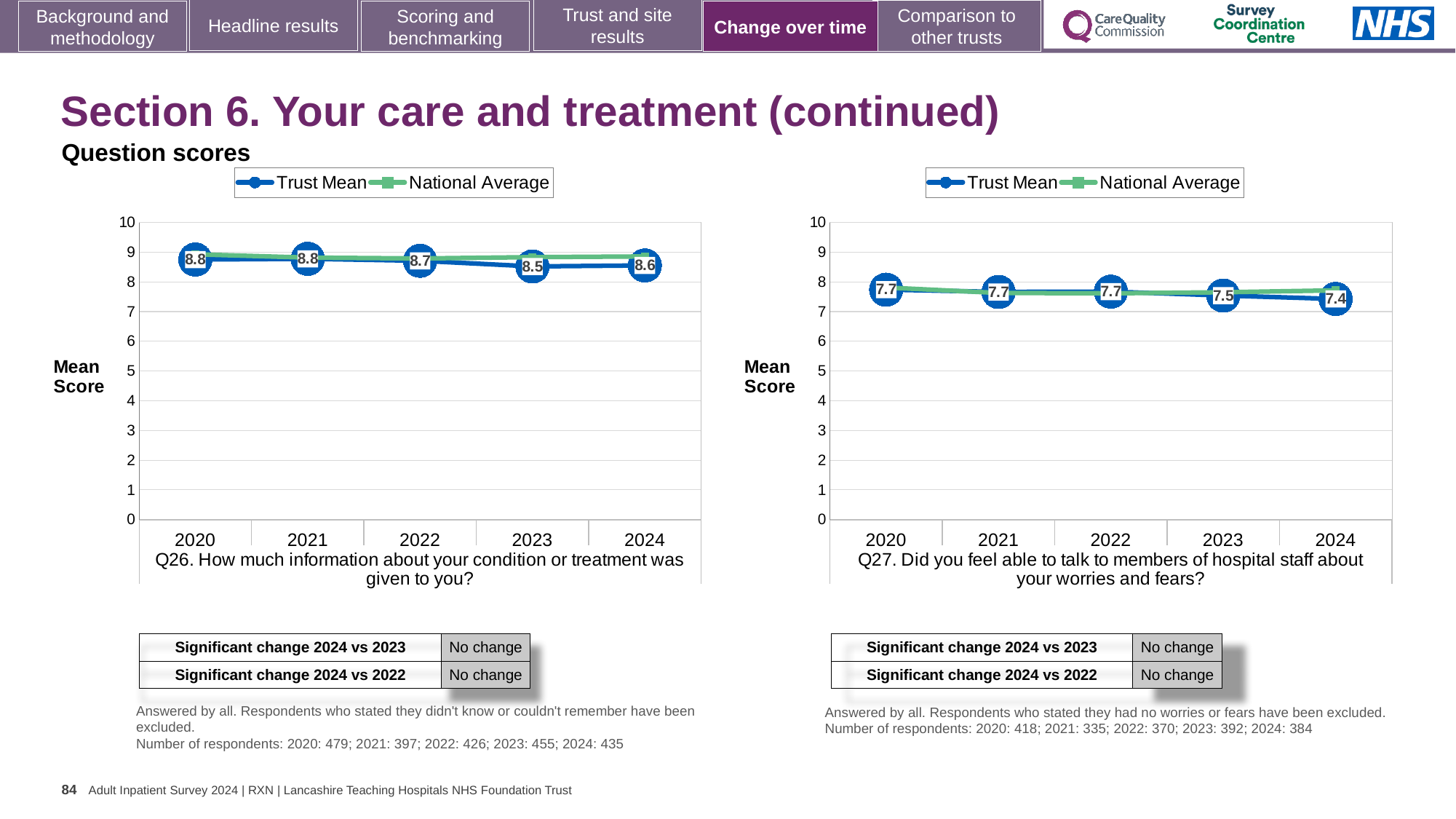
How many series does the legend of the Q26 chart (left) list? 2 In the Q26 chart (left), what is the difference between the Trust Mean scores for 2020 and 2023? 0.3 In the Q26 chart (left), what is the Trust Mean score for 2023? 8.5 In the Q26 chart (left), which year has the lowest Trust Mean score? 2023 In the Q27 chart (right), is the Trust Mean score for 2023 larger or smaller than the score for 2024? larger In the Q26 chart (left), how many years are plotted on the x axis? 5 In the Q27 chart (right), which year has the lowest Trust Mean score? 2024 In the Q27 chart (right), what is the Trust Mean score for 2024? 7.4 In the Q27 chart (right), what is the Trust Mean score for 2022? 7.7 What kind of chart is the Q27 chart (right)? line chart In the Q26 chart (left), what is the Trust Mean score for 2020? 8.8 In the Q27 chart (right), does the Trust Mean score rise or fall from 2022 to 2024? fall